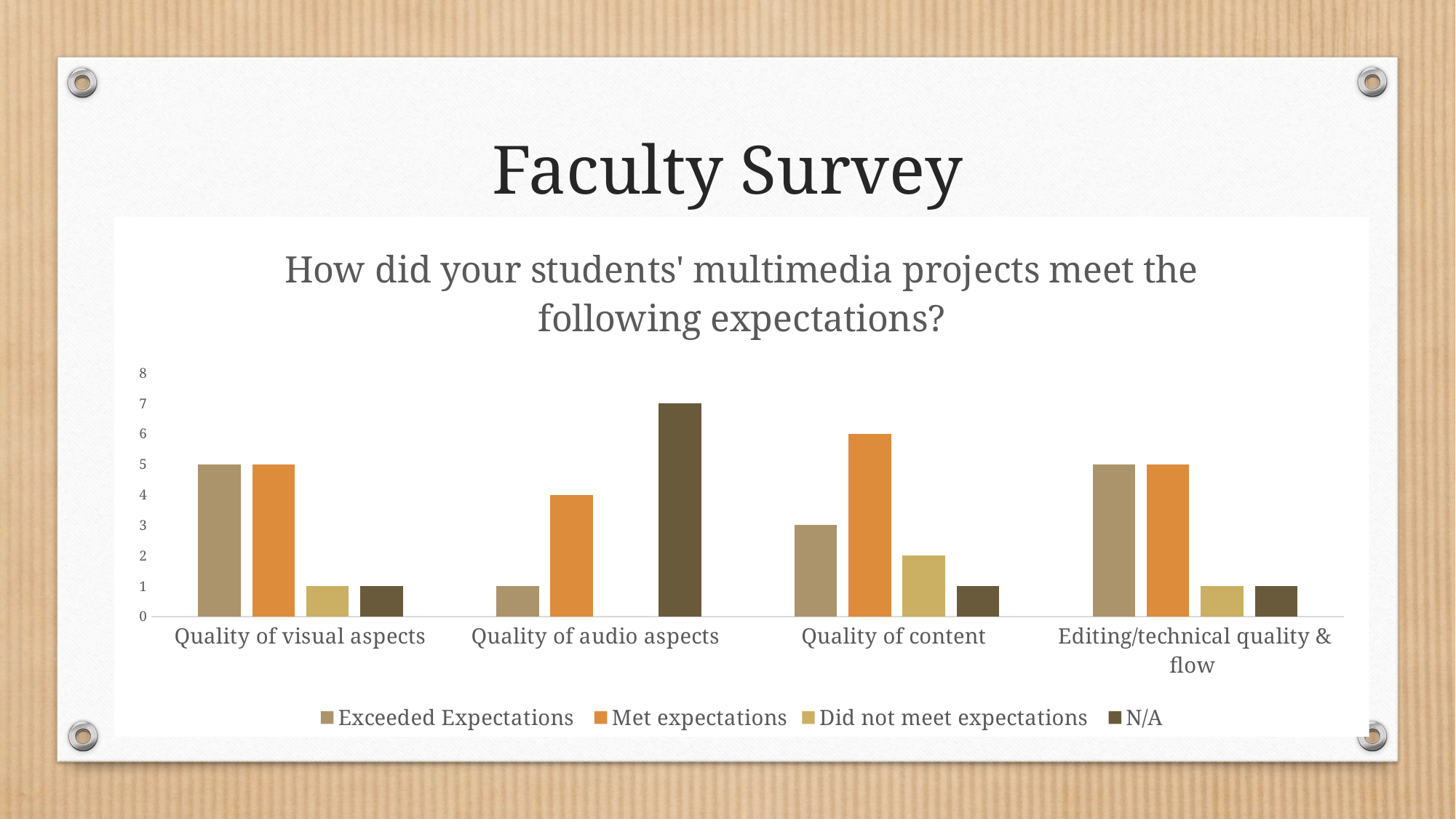
Which category has the lowest Exceeded Expectations value? Quality of audio aspects Which category has the highest N/A value? Quality of audio aspects What is the difference between the Met expectations value and the Exceeded Expectations value in the Quality of content category? 3 How many categories are shown on the x axis? 4 What is the value for Exceeded Expectations in the Quality of visual aspects category? 5 How many series does the legend list? 4 Which is larger in the Quality of audio aspects category: Met expectations or N/A? N/A What is the title of the chart? How did your students' multimedia projects meet the following expectations? Is the value for Met expectations in the Quality of audio aspects category greater or less than 2? greater What is the value for Met expectations in the Quality of content category? 6 What kind of chart is shown on the slide? bar chart What is the value for N/A in the Quality of audio aspects category? 7